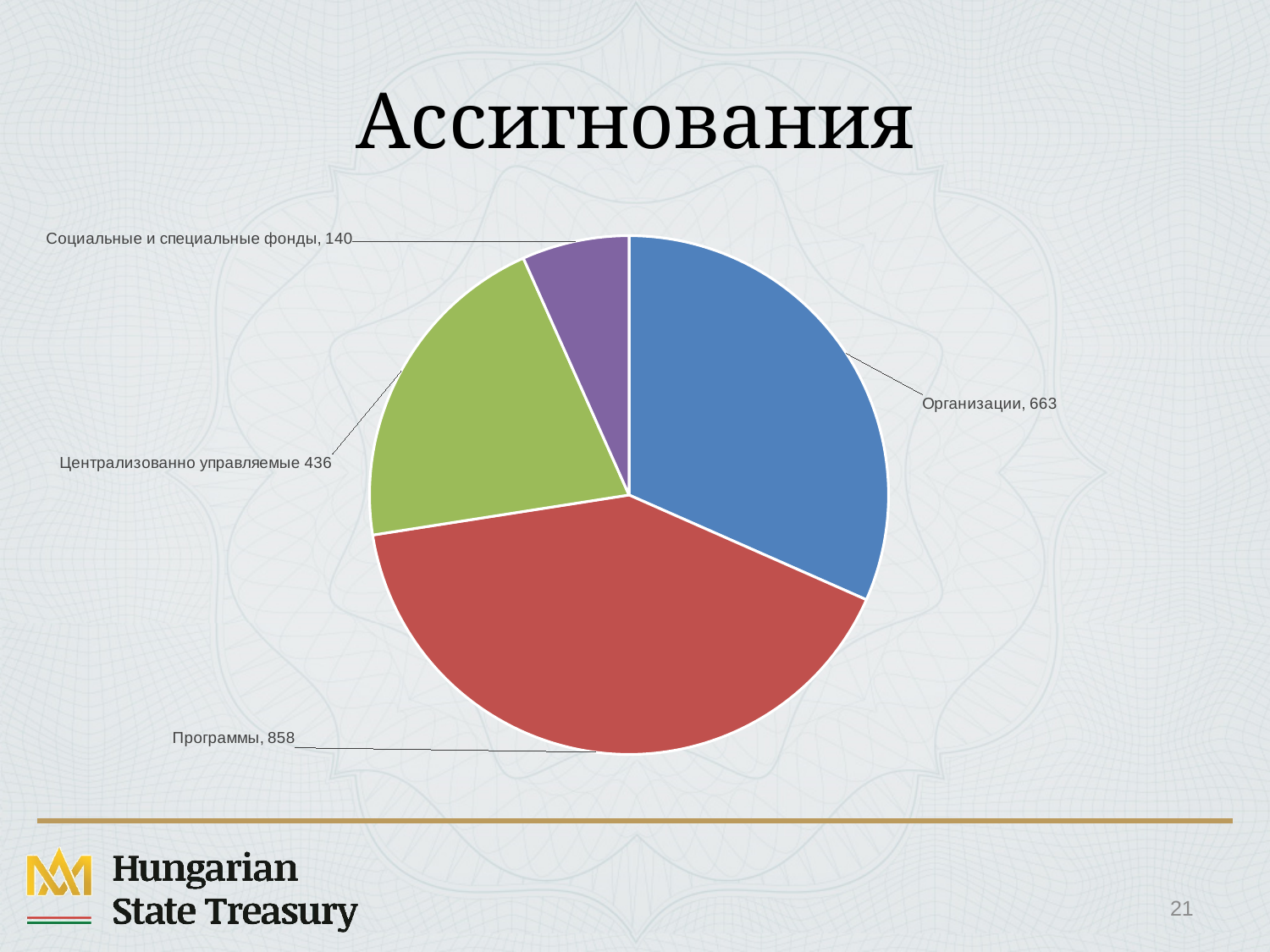
What is the difference between the values for Программы and Организации? 195 Which category has the largest slice of the pie? Программы What is the value for Социальные и специальные фонды? 140 Which is larger, the value for Организации or the value for Централизованно управляемые? Организации What is the value for Организации? 663 What is the title of the chart on the slide? Ассигнования How many slices does the pie chart have? 4 What is the total of all the slices in the pie chart? 2097 What type of chart is shown on the slide? Pie chart Which category has the smallest slice of the pie? Социальные и специальные фонды What is the value for Централизованно управляемые? 436 What is the value for Программы? 858